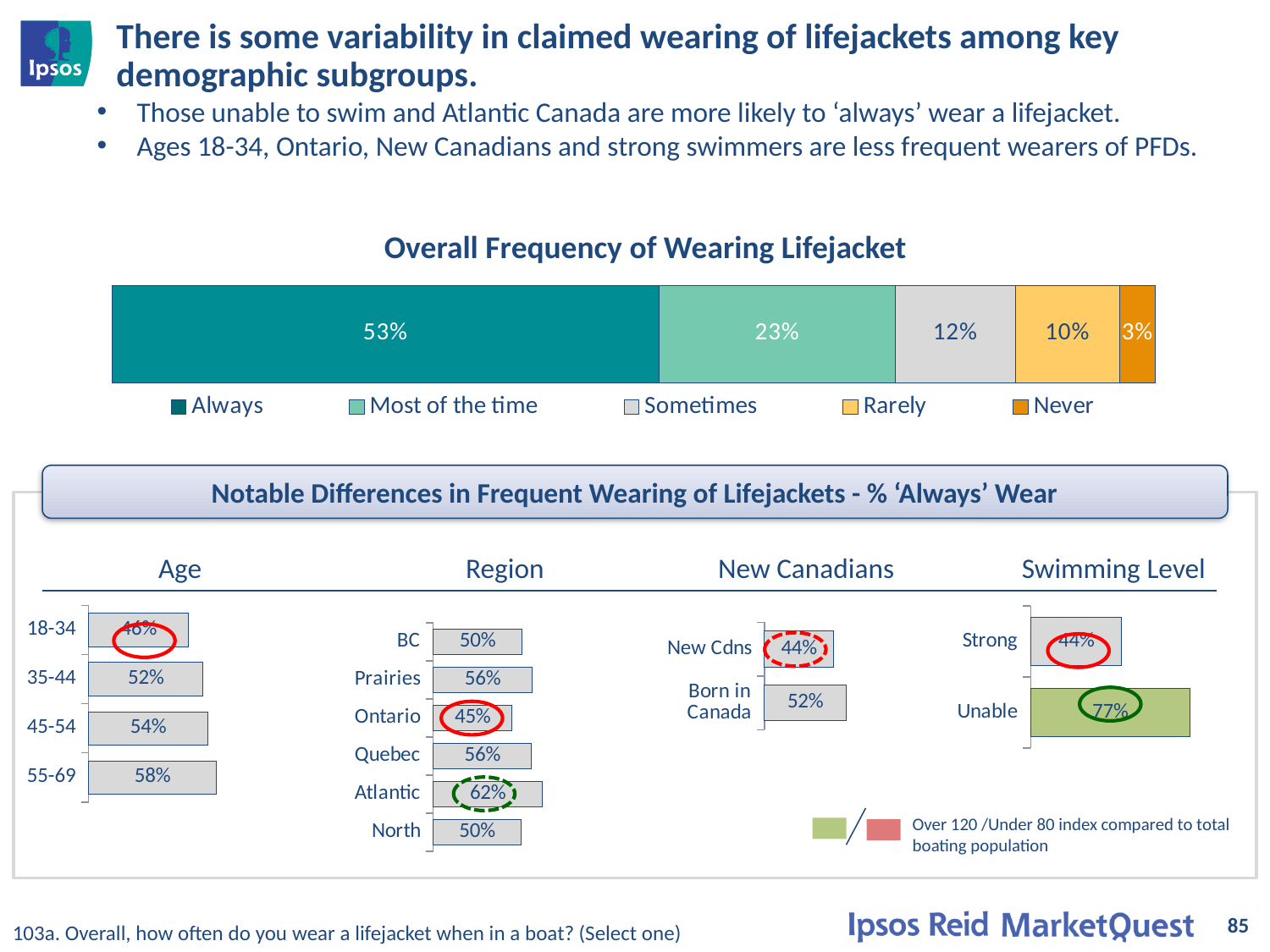
In the Overall Frequency of Wearing Lifejacket chart, what is the difference between the 'Most of the time' and 'Sometimes' percentages? 11 percentage points How many series does the legend of the Overall Frequency of Wearing Lifejacket chart list? 5 In the Age chart, what is the value for the 45-54 age group? 54% In the New Canadians chart, what is the value for Born in Canada? 52% In the Swimming Level chart, what is the value for Unable? 77% In the Region chart, which region has the lowest % 'Always' wear? Ontario In the Age chart, which age group has the highest % 'Always' wear? 55-69 In the Overall Frequency of Wearing Lifejacket chart, what percentage is shown for 'Never'? 3% In the Overall Frequency of Wearing Lifejacket chart, what percentage of respondents say they 'Always' wear a lifejacket? 53% In the Region chart, which region has the highest % 'Always' wear? Atlantic How many regions are shown in the Region chart? 6 In the Region chart, which is larger, the value for Prairies or the value for BC? Prairies